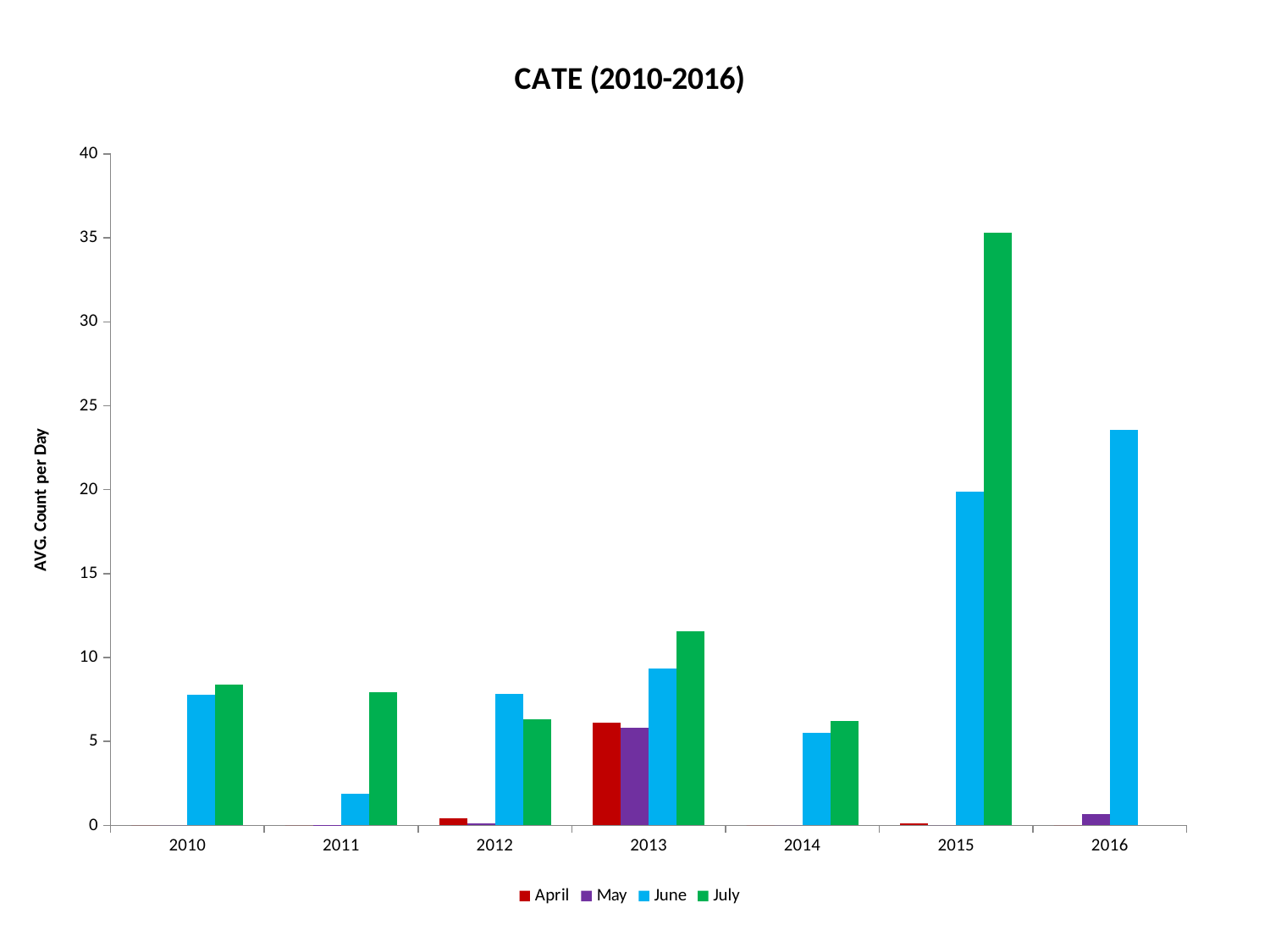
Is the July value for 2013 greater or less than 10? greater Is the June value for 2016 greater or less than 20? greater In which year is the July value highest? 2015 In which year is the June value highest? 2016 What kind of chart is shown on the slide? bar chart Is the June value for 2015 greater or less than 15? greater How many years are shown along the x axis? 7 How many series does the legend list? 4 In 2012, which is larger, the June value or the July value? June In 2013, which is larger, the June value or the July value? July What is the title of the y axis? AVG. Count per Day